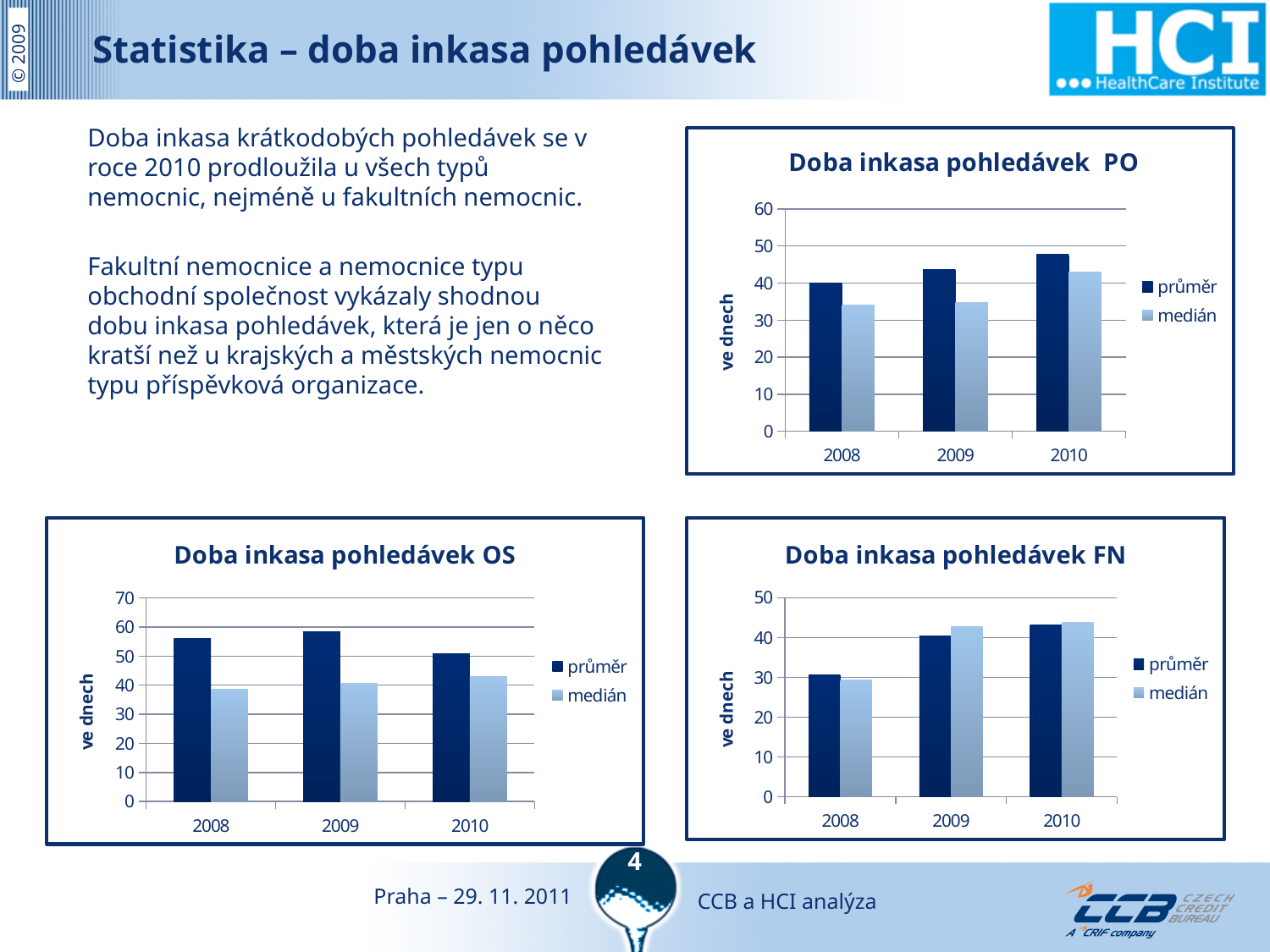
In the chart titled "Doba inkasa pohledávek FN", is the průměr value for 2008 greater or less than 40? less In the chart titled "Doba inkasa pohledávek PO", does the průměr series rise or fall from 2008 to 2010? rises In the chart titled "Doba inkasa pohledávek OS", is the průměr value for 2008 greater or less than 50? greater In the chart titled "Doba inkasa pohledávek OS", which is larger for 2010, průměr or medián? průměr In the chart titled "Doba inkasa pohledávek FN", what is the label on the vertical axis? ve dnech In the chart titled "Doba inkasa pohledávek PO", how many years are shown on the x axis? 3 In the chart titled "Doba inkasa pohledávek PO", what kind of chart is shown? bar chart In the chart titled "Doba inkasa pohledávek PO", is the průměr value for 2010 greater or less than 40? greater In the chart titled "Doba inkasa pohledávek OS", which year has the lowest průměr value? 2010 In the chart titled "Doba inkasa pohledávek PO", which year has the highest průměr value? 2010 In the chart titled "Doba inkasa pohledávek FN", which year has the lowest průměr value? 2008 In the chart titled "Doba inkasa pohledávek PO", how many series does the legend list? 2